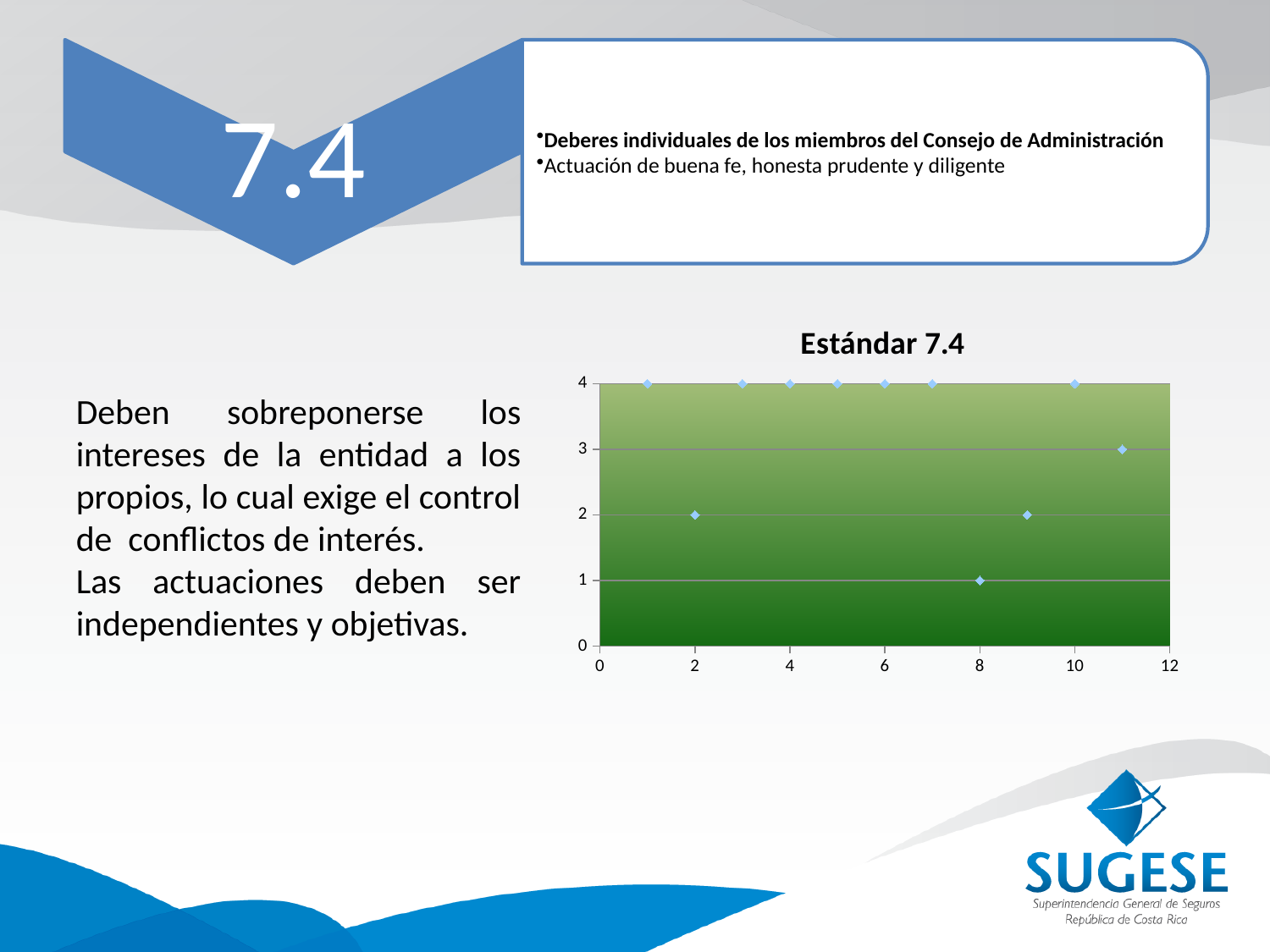
How many points have a y value of 4? 7 At which x value does the lowest point occur? 8 What kind of chart is shown on the slide? scatter chart What is the y value of the point at x = 9? 2 Which has a higher y value, the point at x = 11 or the point at x = 9? x = 11 What is the y value of the point at x = 8? 1 What is the y value of the point at x = 11? 3 What is the y value of the point at x = 2? 2 What is the difference between the y values at x = 1 and x = 8? 3 How many data points are plotted in the chart? 11 What is the title of the chart? Estándar 7.4 What is the maximum value shown on the y axis? 4